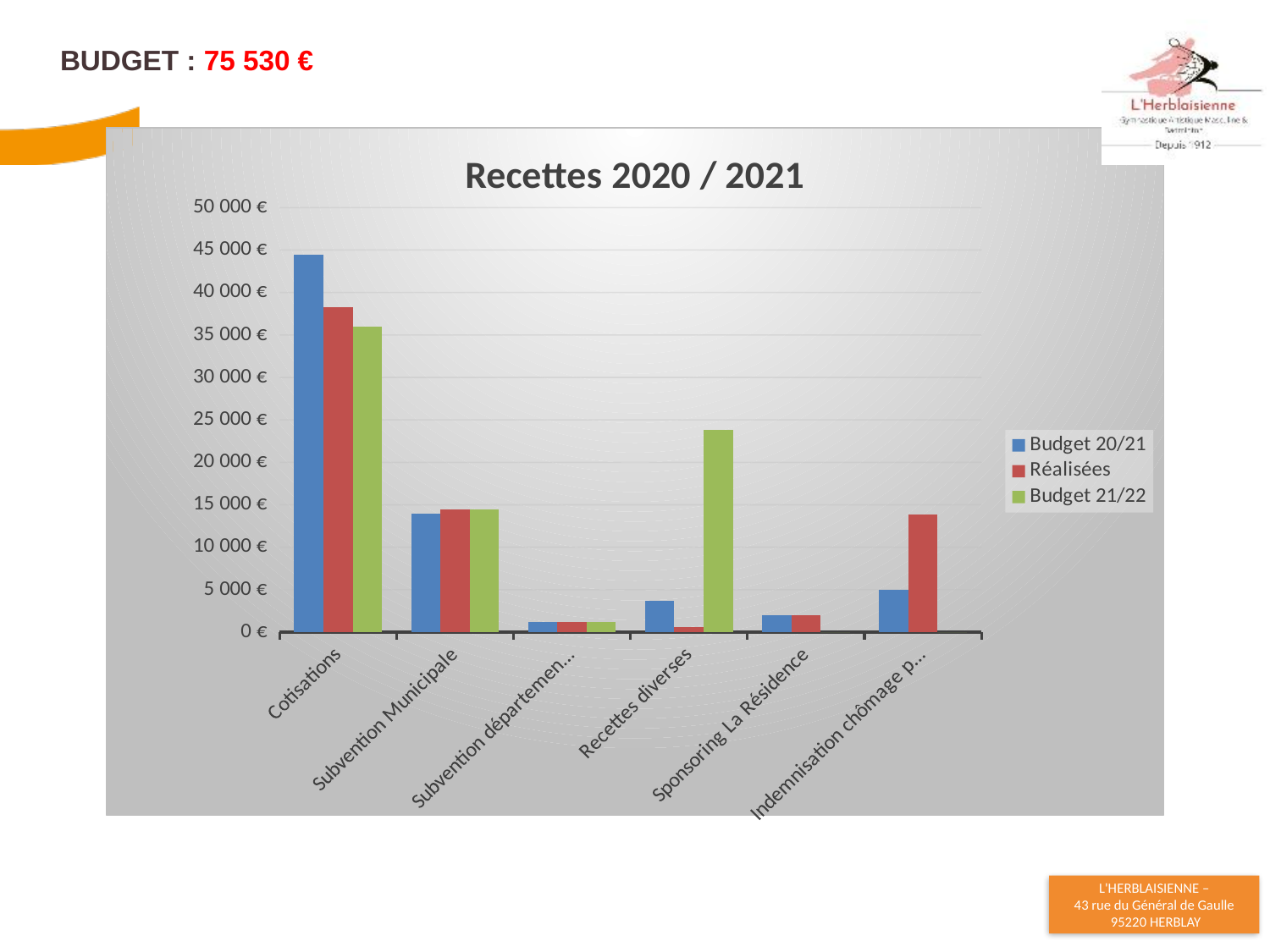
Is the Budget 20/21 value for Cotisations greater or less than 40 000 €? greater Which series is shown in green in the chart legend? Budget 21/22 What type of chart is shown on the slide? Bar chart For Cotisations, which is larger: the Budget 20/21 value or the Réalisées value? Budget 20/21 Is the Budget 21/22 value for Recettes diverses greater or less than 20 000 €? greater What is the title of the chart? Recettes 2020 / 2021 Which category has the highest Budget 20/21 value? Cotisations Is the Réalisées value for Cotisations greater or less than 35 000 €? greater For Recettes diverses, which is larger: the Budget 20/21 value or the Budget 21/22 value? Budget 21/22 How many series does the chart legend list? 3 How many categories are shown on the x axis of the chart? 6